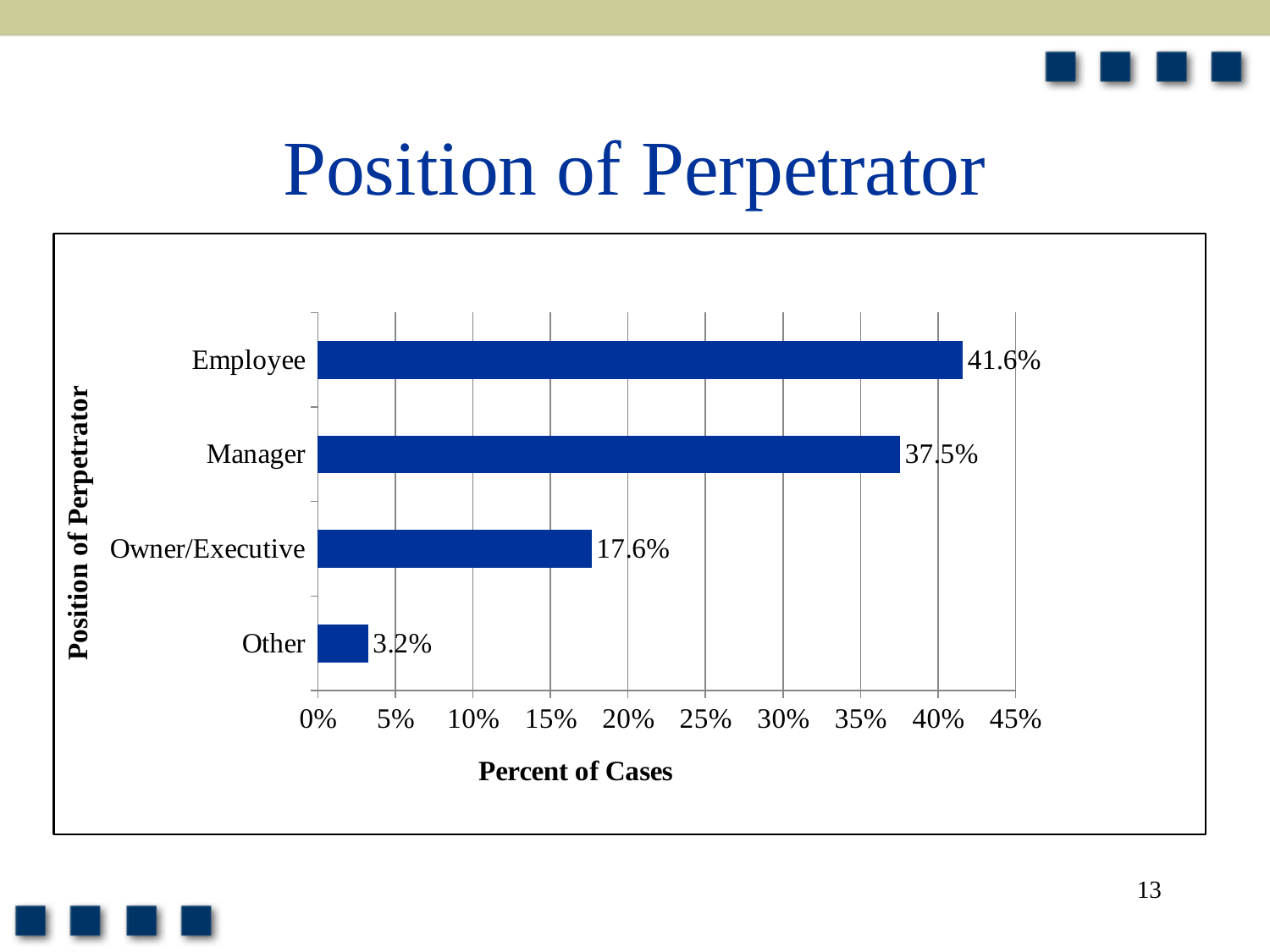
What is the difference in percent of cases between Employee and Manager? 4.1% Which has a larger percent of cases, Manager or Owner/Executive? Manager Which position of perpetrator has the lowest percent of cases? Other How many positions of perpetrator are shown in the chart? 4 Which position of perpetrator has the highest percent of cases? Employee What is the percent of cases for Owner/Executive? 17.6% What is the percent of cases for Other? 3.2% What is the difference in percent of cases between Owner/Executive and Other? 14.4% What is the percent of cases for Employee? 41.6% What is the percent of cases for Manager? 37.5% What is the label of the horizontal axis of the chart? Percent of Cases What kind of chart is shown on the slide? Bar chart